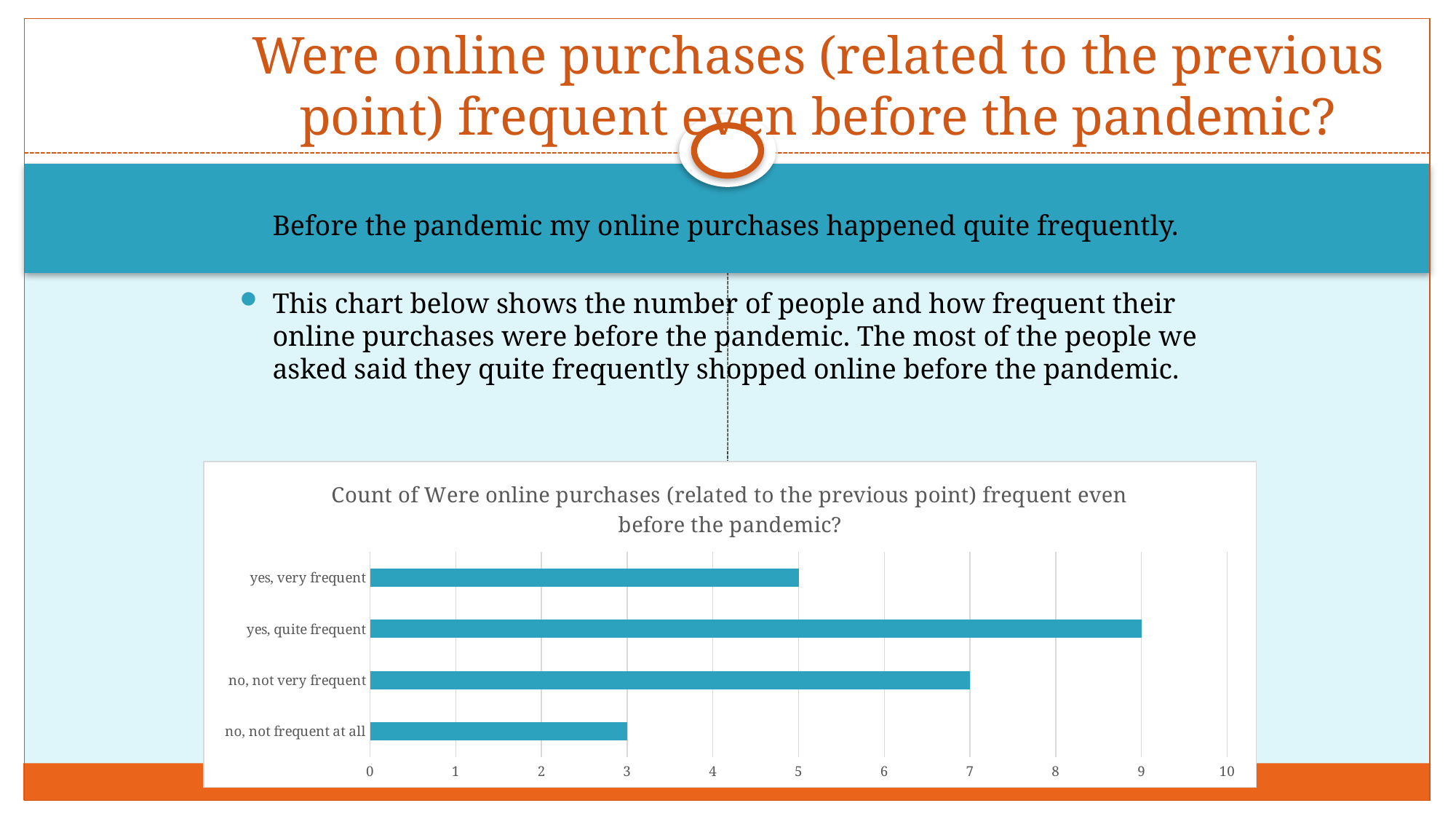
Is the value for "yes, quite frequent" greater or less than 8? greater Which category has the lowest value? no, not frequent at all How many categories does the chart show? 4 Which category has the highest value? yes, quite frequent Which is larger, the value for "no, not very frequent" or the value for "yes, very frequent"? no, not very frequent What is the value for "yes, very frequent"? 5 What is the value for "no, not frequent at all"? 3 What is the value for "yes, quite frequent"? 9 What is the value for "no, not very frequent"? 7 What kind of chart is shown on the slide? bar chart What is the difference between the values for "yes, quite frequent" and "no, not frequent at all"? 6 What is the highest value shown on the chart's horizontal axis? 10